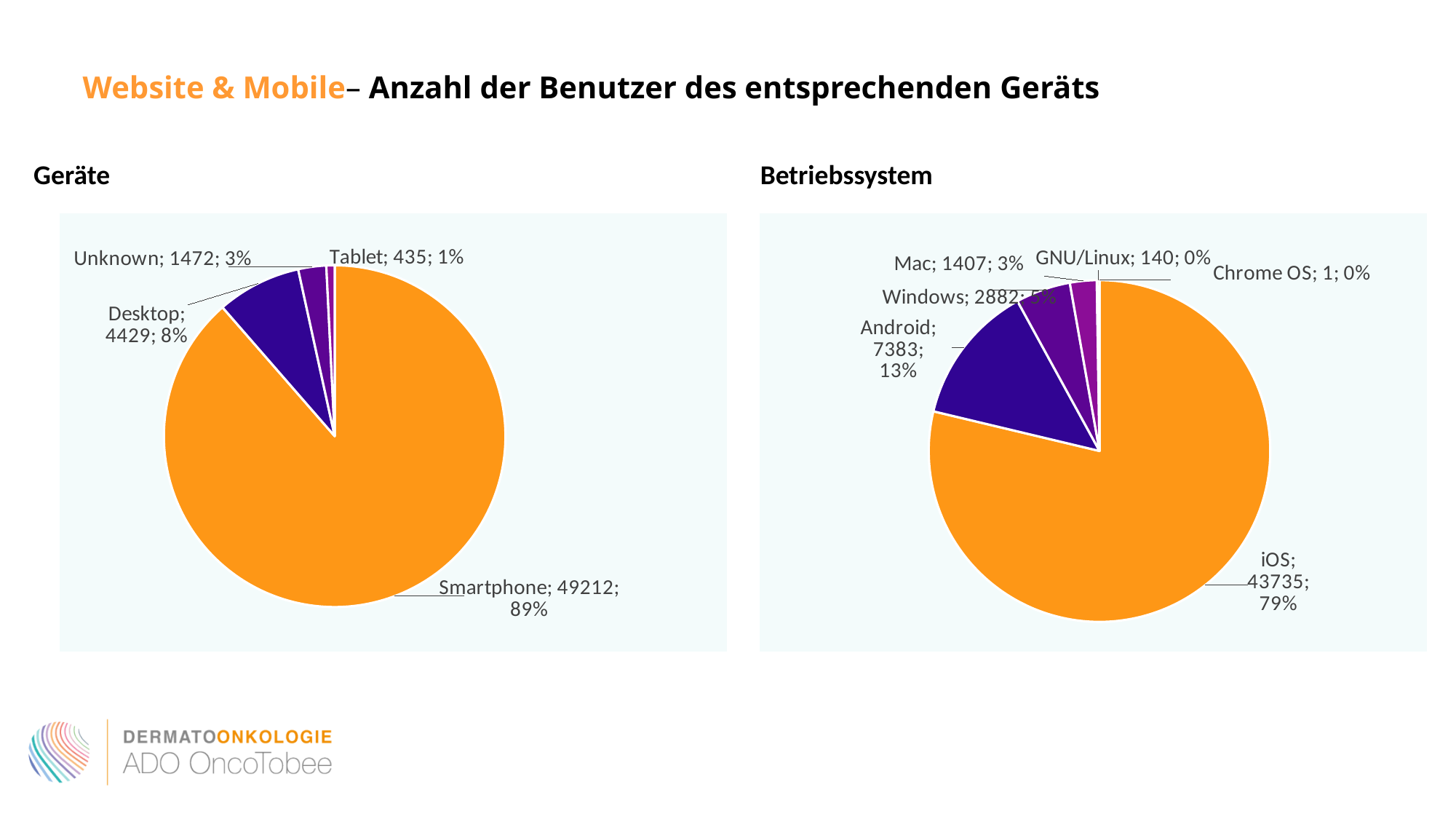
In the Geräte chart, which category has the smallest number of users? Tablet In the Betriebssystem chart, what share of the pie does iOS have? 79% How many categories does the Betriebssystem pie chart show? 6 In the Betriebssystem chart, how many users are shown for Android? 7383 How many categories does the Geräte pie chart show? 4 In the Betriebssystem chart, which has more users, Windows or Mac? Windows In the Geräte chart, how many users are shown for Smartphone? 49212 In the Geräte chart, what is the difference in users between Desktop and Unknown? 2957 In the Geräte chart, what share of the pie does Desktop have? 8% What type of chart is used for the Geräte data? Pie chart In the Betriebssystem chart, what is the difference in users between Android and Windows? 4501 In the Betriebssystem chart, which category has the largest number of users? iOS